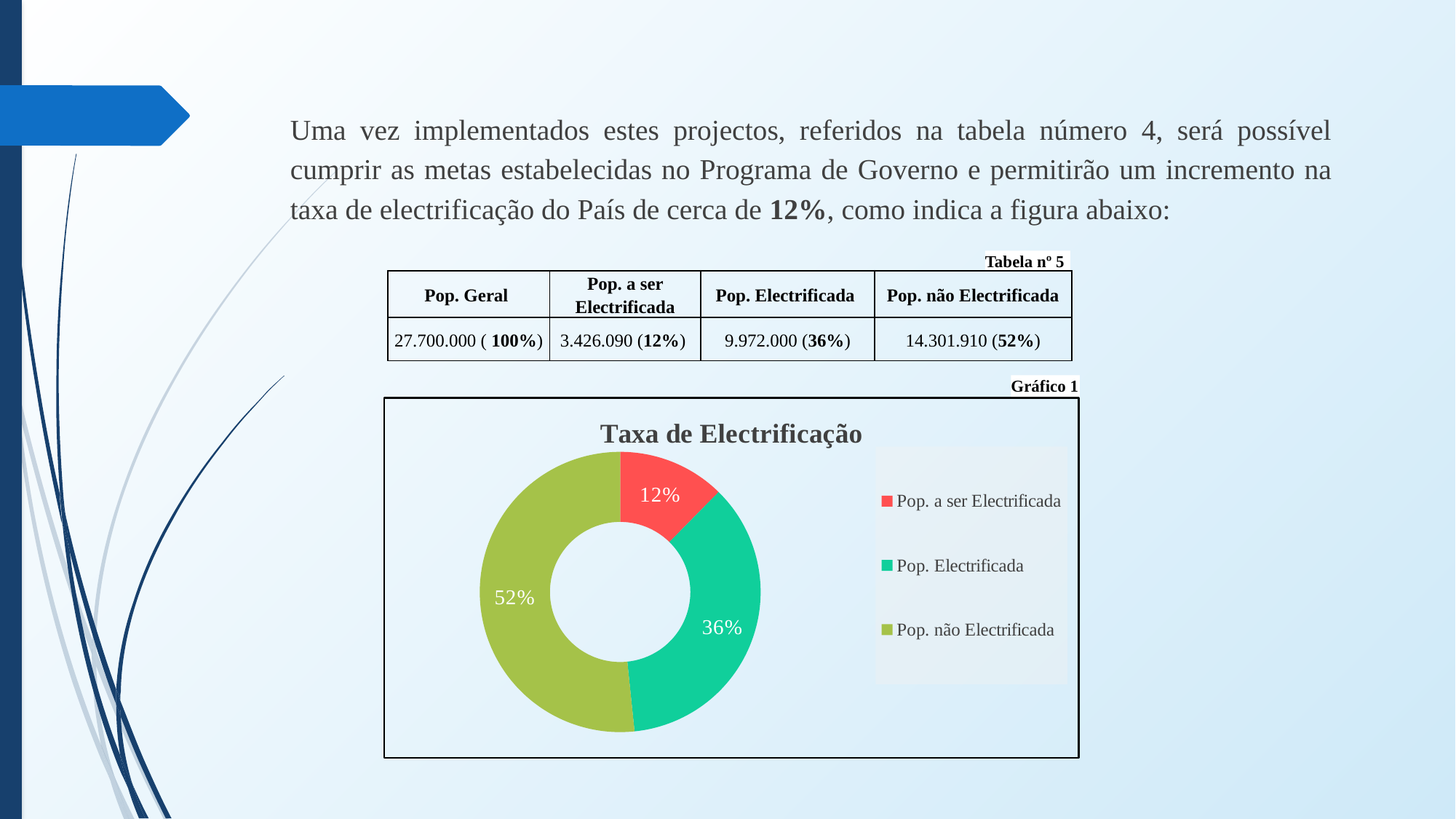
What is the difference in percentage points between the 'Pop. não Electrificada' and 'Pop. Electrificada' shares? 16% Which category has the largest share in the doughnut chart? Pop. não Electrificada What share of the doughnut chart is labelled 'Pop. Electrificada'? 36% What colour represents 'Pop. não Electrificada' in the doughnut chart? Green What type of chart is shown under the title 'Taxa de Electrificação'? Doughnut chart What share of the doughnut chart is labelled 'Pop. não Electrificada'? 52% What is the title of the chart? Taxa de Electrificação What share of the doughnut chart is labelled 'Pop. a ser Electrificada'? 12% How many categories does the doughnut chart show? 3 Which category has the smallest share in the doughnut chart? Pop. a ser Electrificada Which is larger in the doughnut chart: 'Pop. Electrificada' or 'Pop. a ser Electrificada'? Pop. Electrificada How many entries does the chart legend list? 3